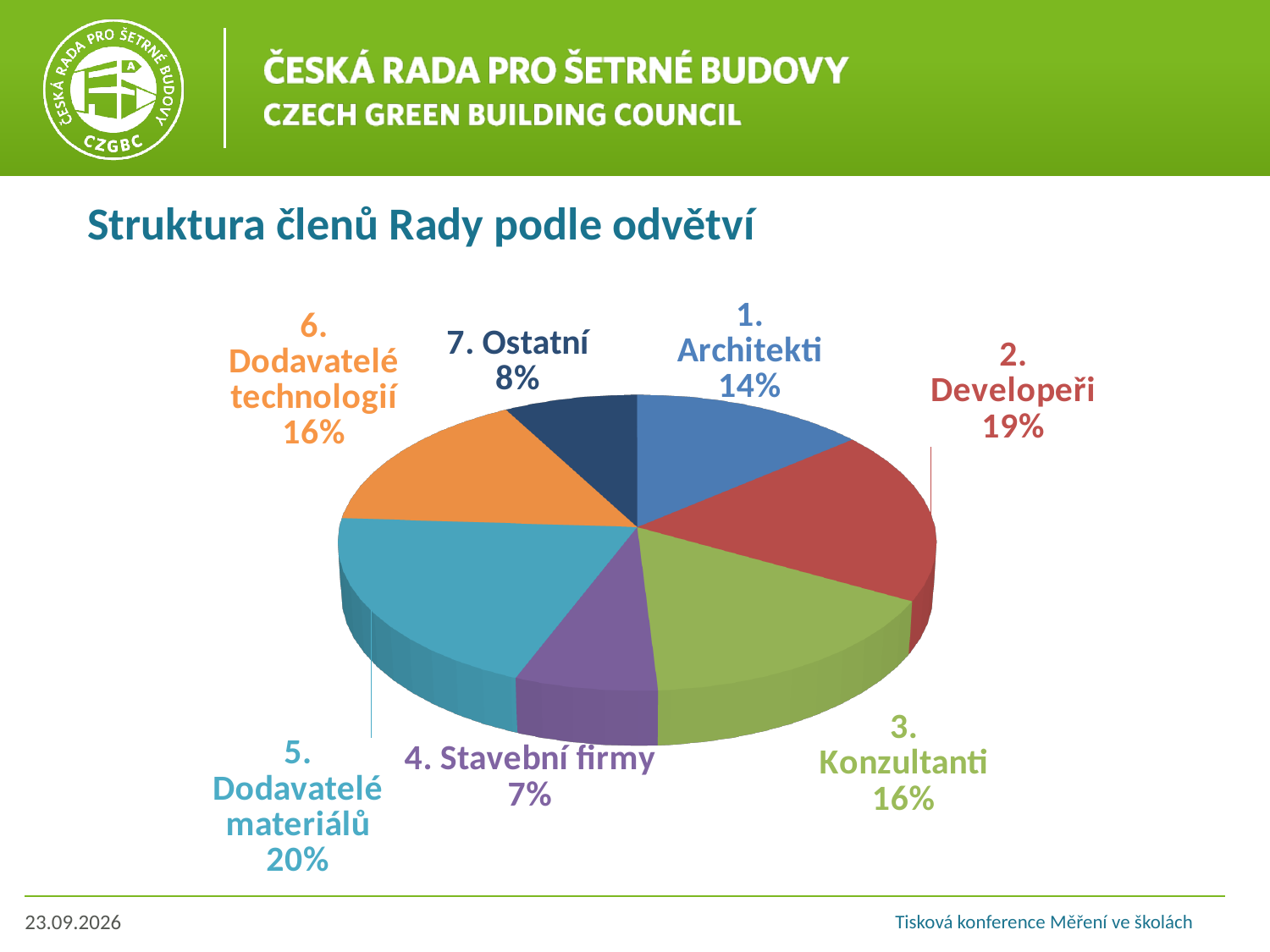
What is the difference between the shares of 2. Developeři and 1. Architekti? 5% Which category has the largest share of the pie? 5. Dodavatelé materiálů What share of the pie does 5. Dodavatelé materiálů hold? 20% What is the combined share of 3. Konzultanti and 6. Dodavatelé technologií? 32% What kind of chart is shown on the slide? Pie chart Which category has the smallest share of the pie? 4. Stavební firmy What is the value for 7. Ostatní? 8% What is the value shown for 2. Developeři? 19% What percentage is shown for 4. Stavební firmy? 7% How many categories does the pie chart show? 7 What is the title of the chart? Struktura členů Rady podle odvětví Which is larger, the share of 1. Architekti or the share of 7. Ostatní? 1. Architekti